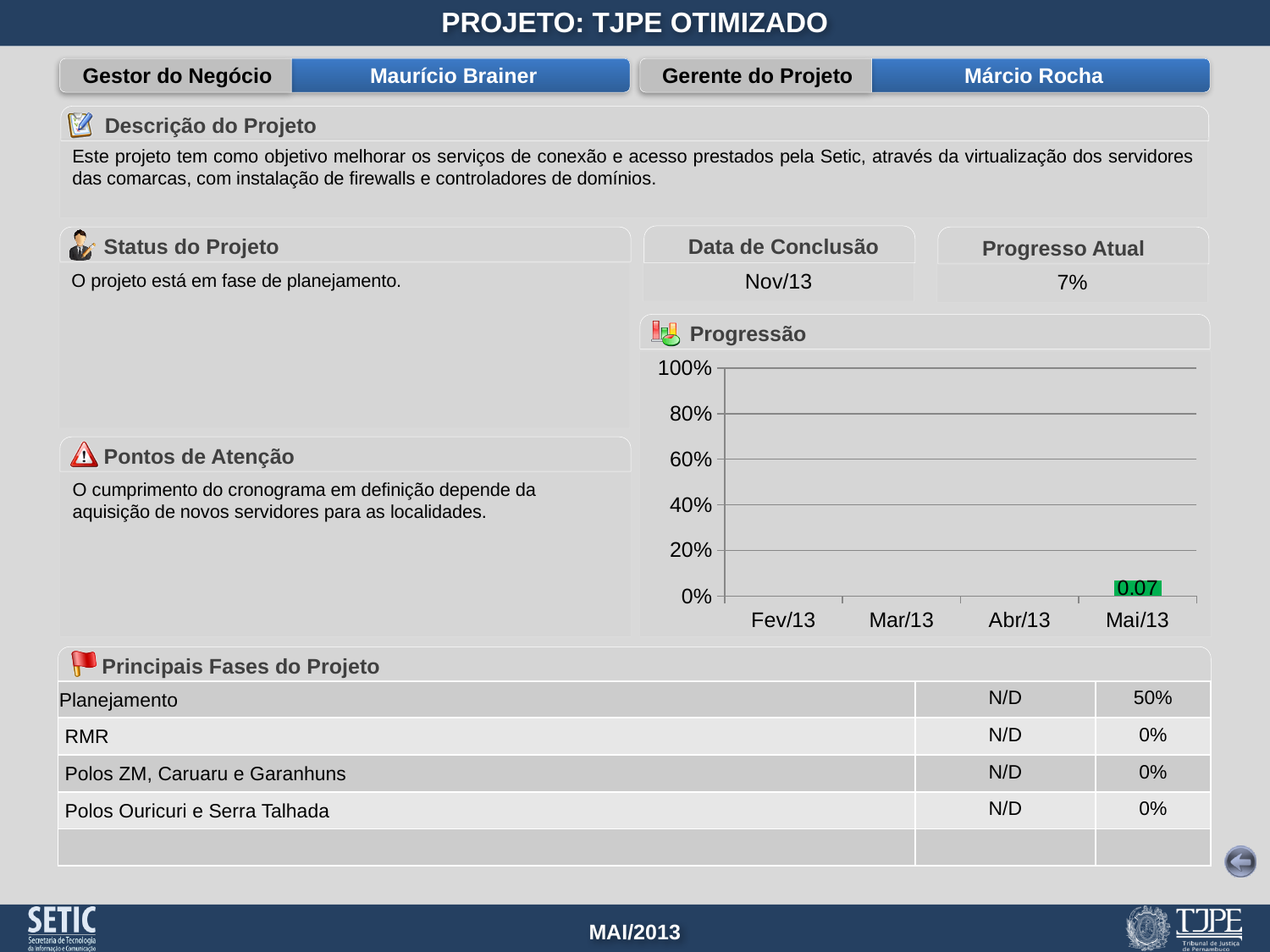
What kind of chart is shown under the heading "Progressão"? bar chart Which month has the highest bar in the Progressão chart? Mai/13 Which is larger in the Progressão chart, the bar for Mai/13 or the bar for Fev/13? Mai/13 How many months are labelled on the x axis of the Progressão chart? 4 Is the value for Mai/13 in the Progressão chart greater or less than 20%? less What is the data label shown on the bar for Mai/13 in the Progressão chart? 0.07 What is the highest tick value shown on the y axis of the Progressão chart? 100% What is the first month labelled on the x axis of the Progressão chart? Fev/13